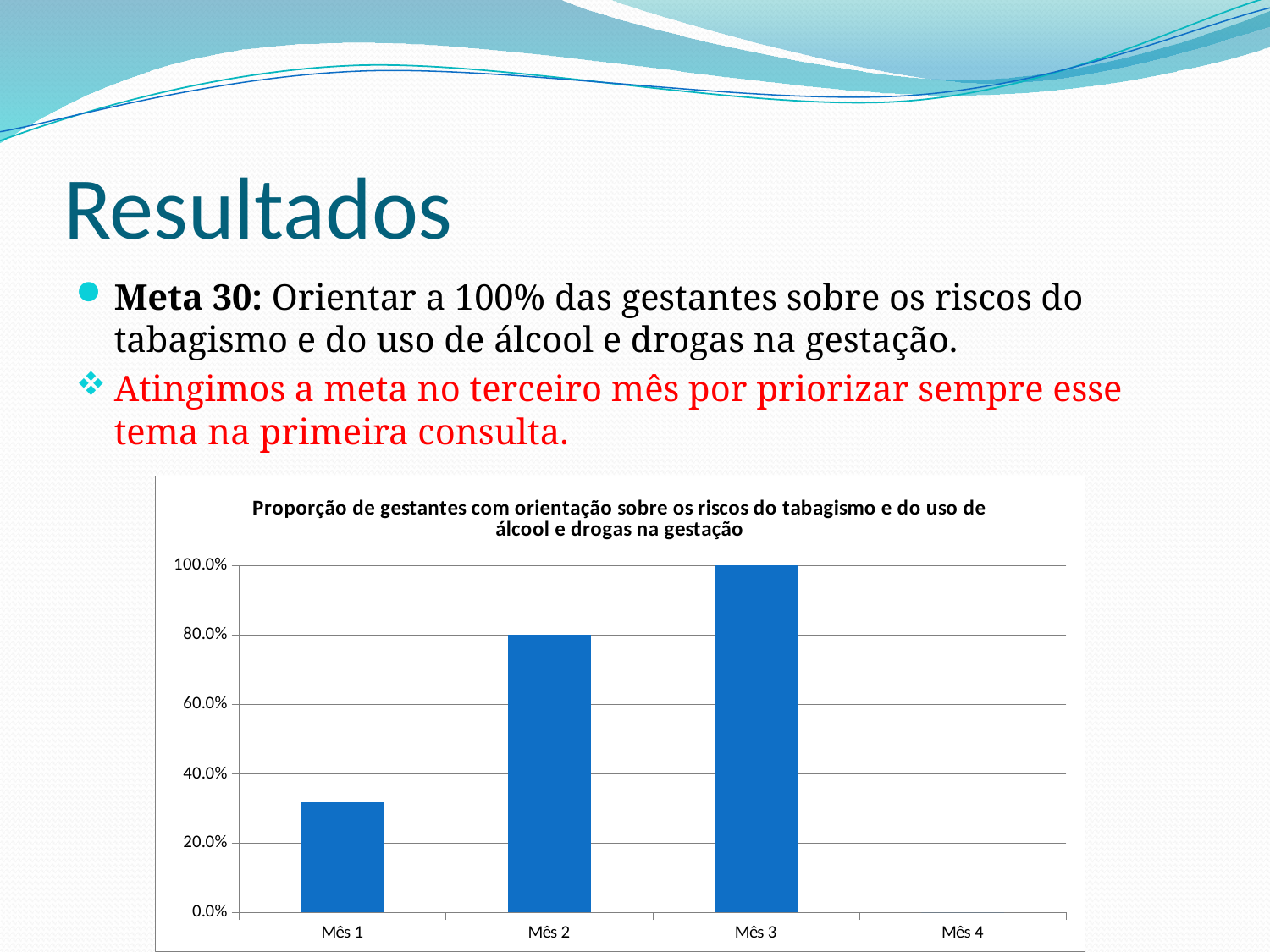
Which is larger, the value for Mês 2 or the value for Mês 3? Mês 3 What is the difference between the values for Mês 3 and Mês 2? 20.0% What kind of chart is shown on the slide? bar chart What is the value for Mês 2? 80.0% Do the values rise or fall from Mês 1 to Mês 3? rise Is the value for Mês 1 greater or less than 40.0%? less Is the value for Mês 1 greater or less than 20.0%? greater Which is larger, the value for Mês 1 or the value for Mês 2? Mês 2 What is the value for Mês 3? 100.0% How many categories are labelled on the x axis? 4 Which month has the highest bar? Mês 3 Which month on the x axis has no bar shown? Mês 4